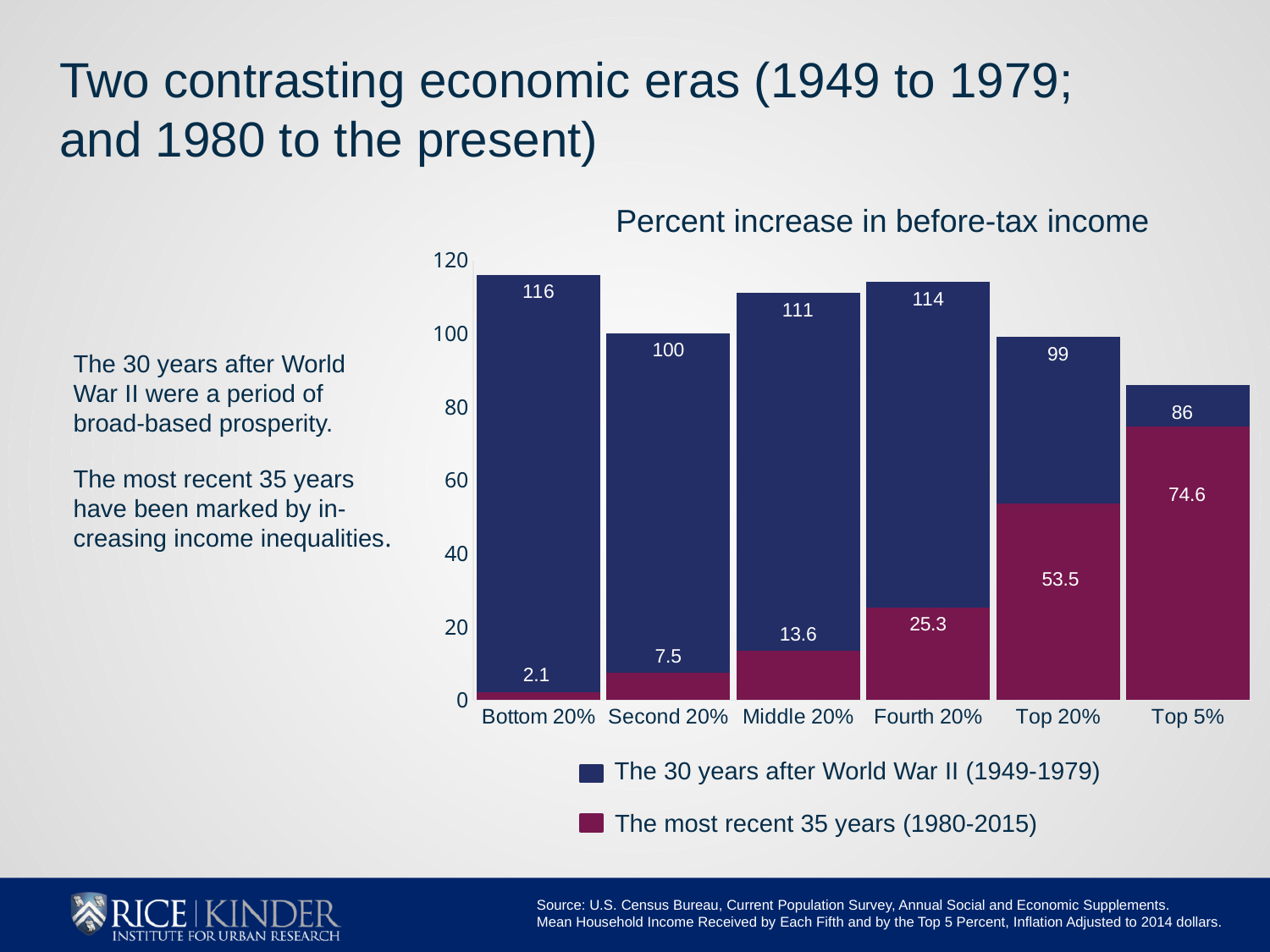
What is the value for the Fourth 20% in the most recent 35 years (1980-2015)? 25.3 What kind of chart is shown on the slide? Bar chart What is the percent increase in before-tax income for the Top 5% in the most recent 35 years (1980-2015)? 74.6 What is the difference between the Top 20% values for 1949-1979 and 1980-2015? 45.5 How many income groups are shown on the x axis? 6 Which is larger: the Middle 20% value for 1949-1979 or the Fourth 20% value for 1949-1979? Fourth 20% Which income group has the lowest percent increase in the most recent 35 years (1980-2015)? Bottom 20% How many series does the legend list? 2 What is the title of the chart? Percent increase in before-tax income What is the percent increase in before-tax income for the Bottom 20% in the 30 years after World War II (1949-1979)? 116 Which income group has the highest percent increase in the 30 years after World War II (1949-1979)? Bottom 20% Do the values for the most recent 35 years (1980-2015) rise or fall from Bottom 20% to Top 5%? Rise